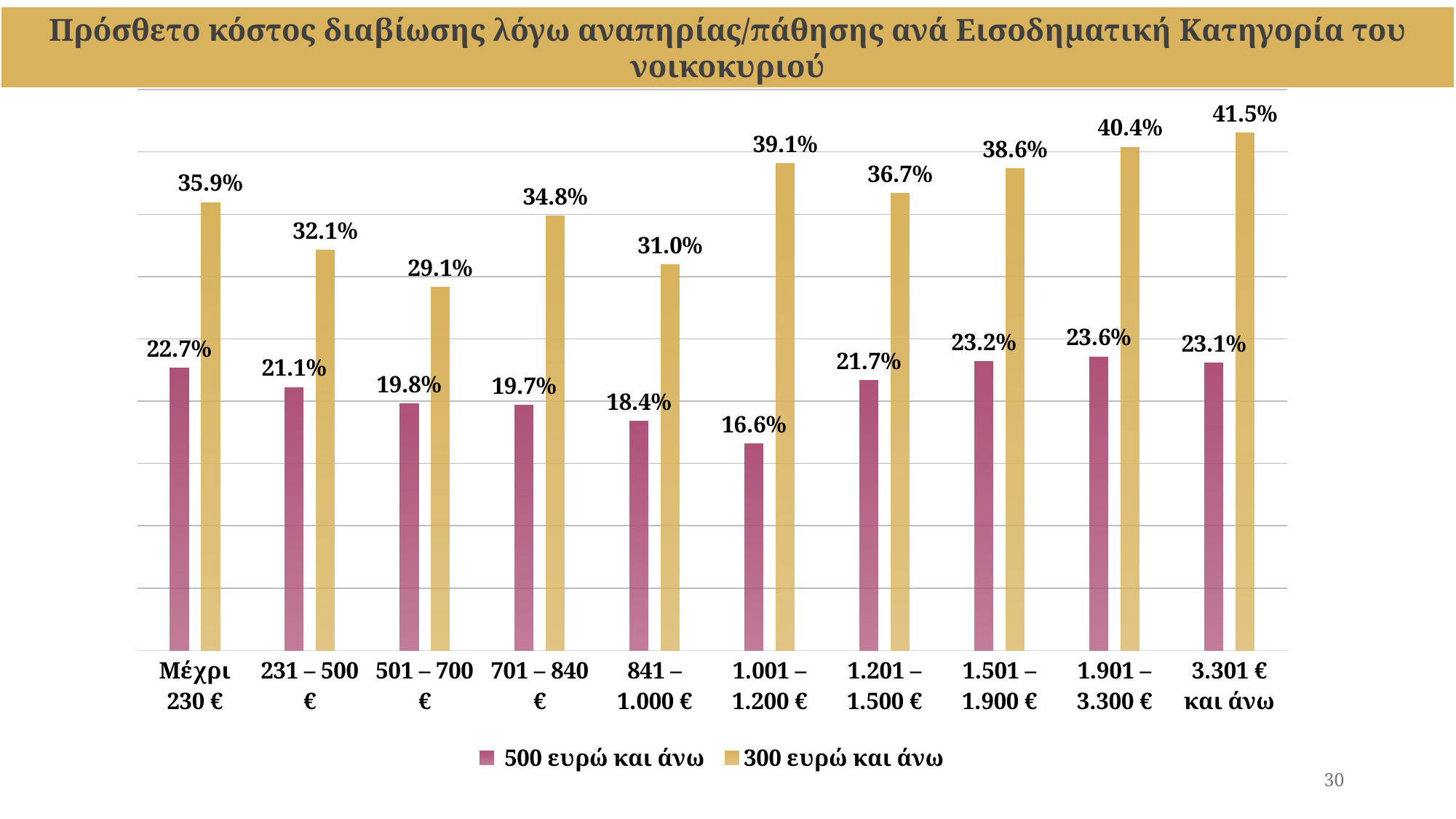
What is the value for the '300 ευρώ και άνω' series in the '3.301 € και άνω' category? 41.5% Which income category has the highest value for the '300 ευρώ και άνω' series? 3.301 € και άνω Which is larger: the '500 ευρώ και άνω' value for 'Μέχρι 230 €' or for '231 – 500 €'? Μέχρι 230 € What kind of chart is shown on the slide? Bar chart What is the value for the '500 ευρώ και άνω' series in the '1.001 – 1.200 €' category? 16.6% Which income category has the lowest value for the '500 ευρώ και άνω' series? 1.001 – 1.200 € Which colour represents the '300 ευρώ και άνω' series? Gold How many income categories are shown on the x axis? 10 How many series does the legend list? 2 What is the value for the '300 ευρώ και άνω' series in the 'Μέχρι 230 €' category? 35.9% Which income category has the lowest value for the '300 ευρώ και άνω' series? 501 – 700 € What is the difference between the '300 ευρώ και άνω' and '500 ευρώ και άνω' values in the '1.001 – 1.200 €' category? 22.5%